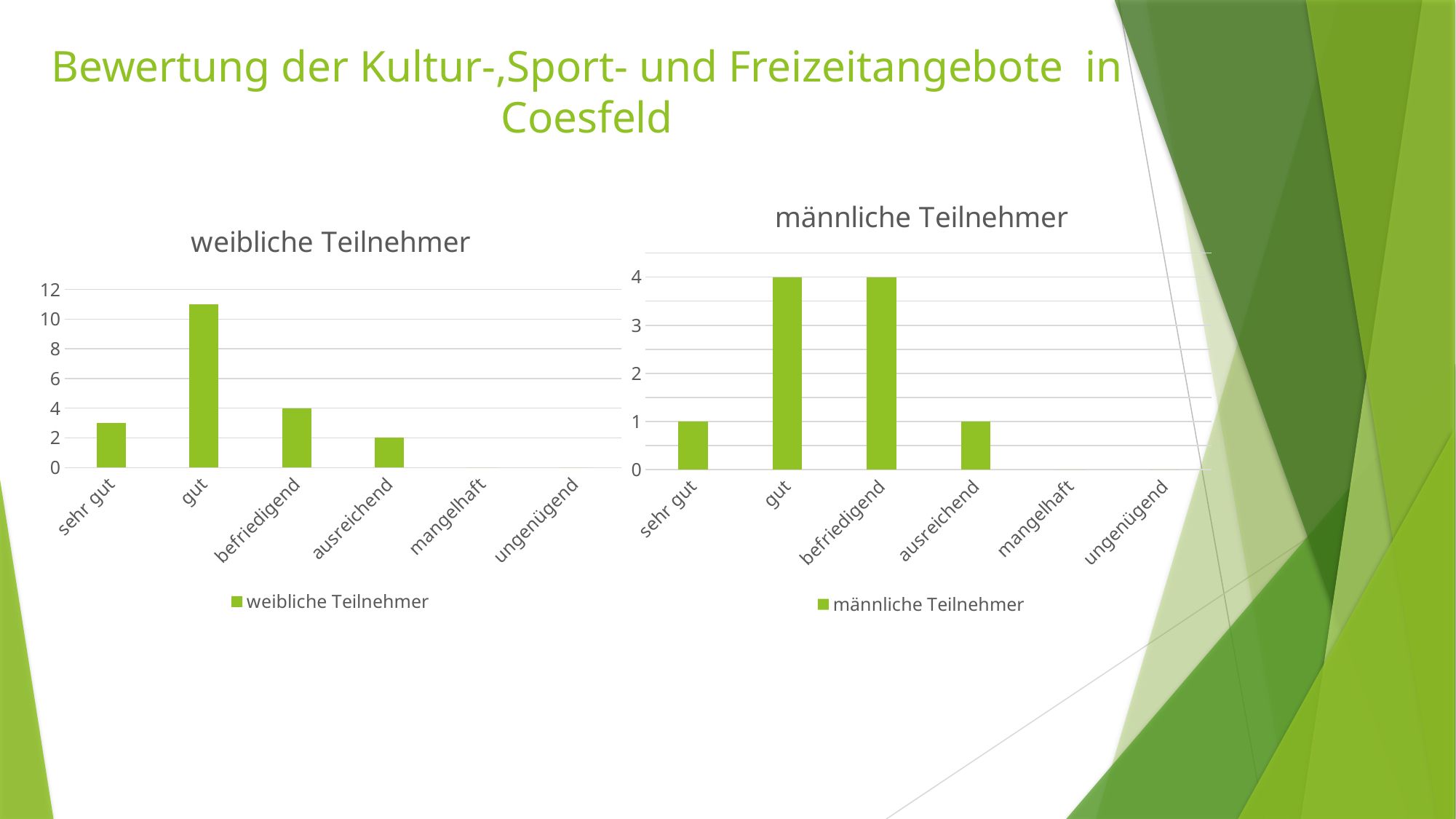
In the 'männliche Teilnehmer' chart, what is the value for 'gut'? 4 In the 'weibliche Teilnehmer' chart, what is the value for 'befriedigend'? 4 In the 'männliche Teilnehmer' chart, what is the difference between the values for 'befriedigend' and 'ausreichend'? 3 What kind of chart is the 'weibliche Teilnehmer' chart? bar chart In the 'weibliche Teilnehmer' chart, is the value for 'sehr gut' greater or less than 4? less How many categories are shown on the x axis of the 'männliche Teilnehmer' chart? 6 In the 'männliche Teilnehmer' chart, which is larger: the value for 'gut' or the value for 'ausreichend'? gut In the 'männliche Teilnehmer' chart, what is the value for 'sehr gut'? 1 In the 'weibliche Teilnehmer' chart, is the value for 'gut' greater or less than 10? greater How many series does the legend of the 'weibliche Teilnehmer' chart list? 1 In the 'weibliche Teilnehmer' chart, which category has the highest value? gut In the 'weibliche Teilnehmer' chart, what is the value for 'ausreichend'? 2